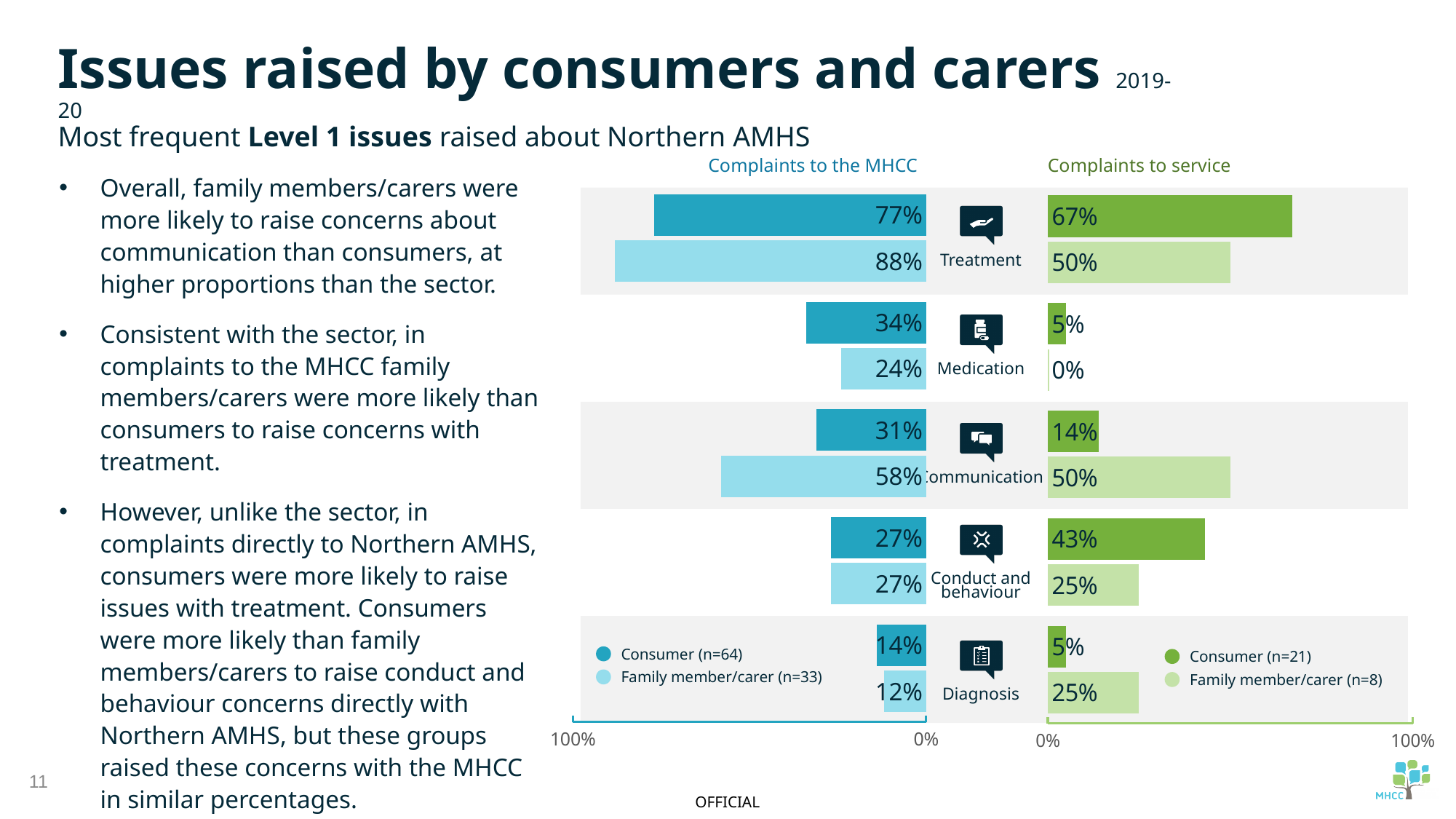
What type of chart is the 'Complaints to the MHCC' chart? Bar chart How many issue categories are shown in the 'Complaints to the MHCC' chart? 5 In the 'Complaints to the MHCC' chart, which issue has the highest percentage for family member/carer? Treatment In the 'Complaints to the MHCC' chart, what is the sample size (n) for consumers shown in the legend? 64 In the 'Complaints to the MHCC' chart, what percentage of family member/carer complaints raised Communication? 58% In the 'Complaints to the MHCC' chart, what is the difference between the family member/carer and consumer percentages for Communication? 27% In the 'Complaints to service' chart, which is larger for Diagnosis: the consumer percentage or the family member/carer percentage? Family member/carer How many series does the legend of the 'Complaints to service' chart list? 2 In the 'Complaints to service' chart, what percentage of family member/carer complaints raised Medication? 0% In the 'Complaints to the MHCC' chart, what percentage of consumer complaints raised Treatment? 77% In the 'Complaints to service' chart, what percentage of consumer complaints raised Conduct and behaviour? 43% In the 'Complaints to service' chart, which issue has the lowest percentage for family member/carer? Medication